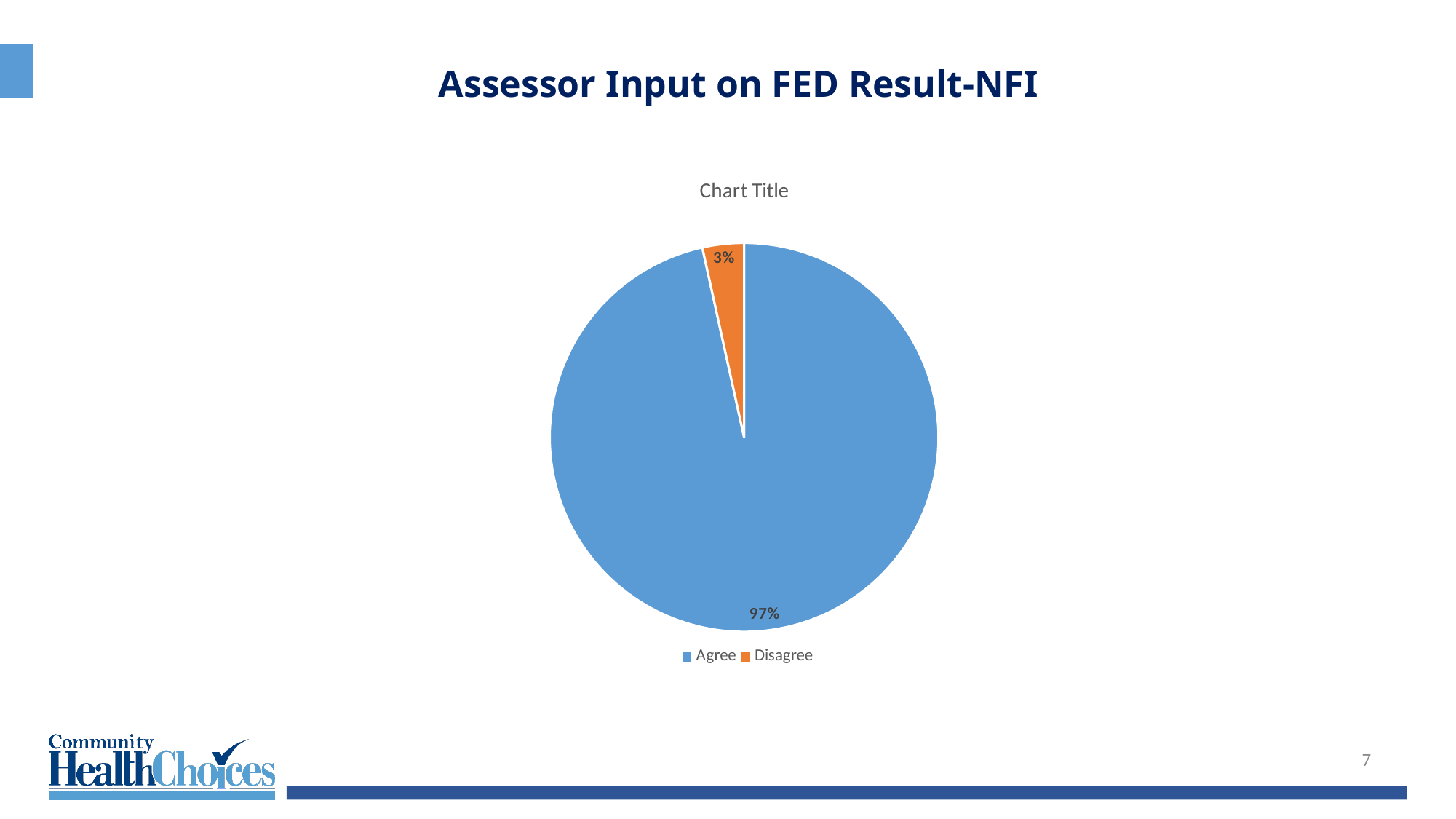
Which is larger, the Agree slice or the Disagree slice? Agree What share of the pie is labelled Agree? 97% What is the difference in percentage points between the Agree and Disagree slices? 94 Which category has the smallest slice of the pie? Disagree What is the title shown above the pie chart? Chart Title What colour is the Disagree slice? orange How many categories does the legend list? 2 What kind of chart is shown on the slide? pie chart What share of the pie is labelled Disagree? 3% Which category has the largest slice of the pie? Agree